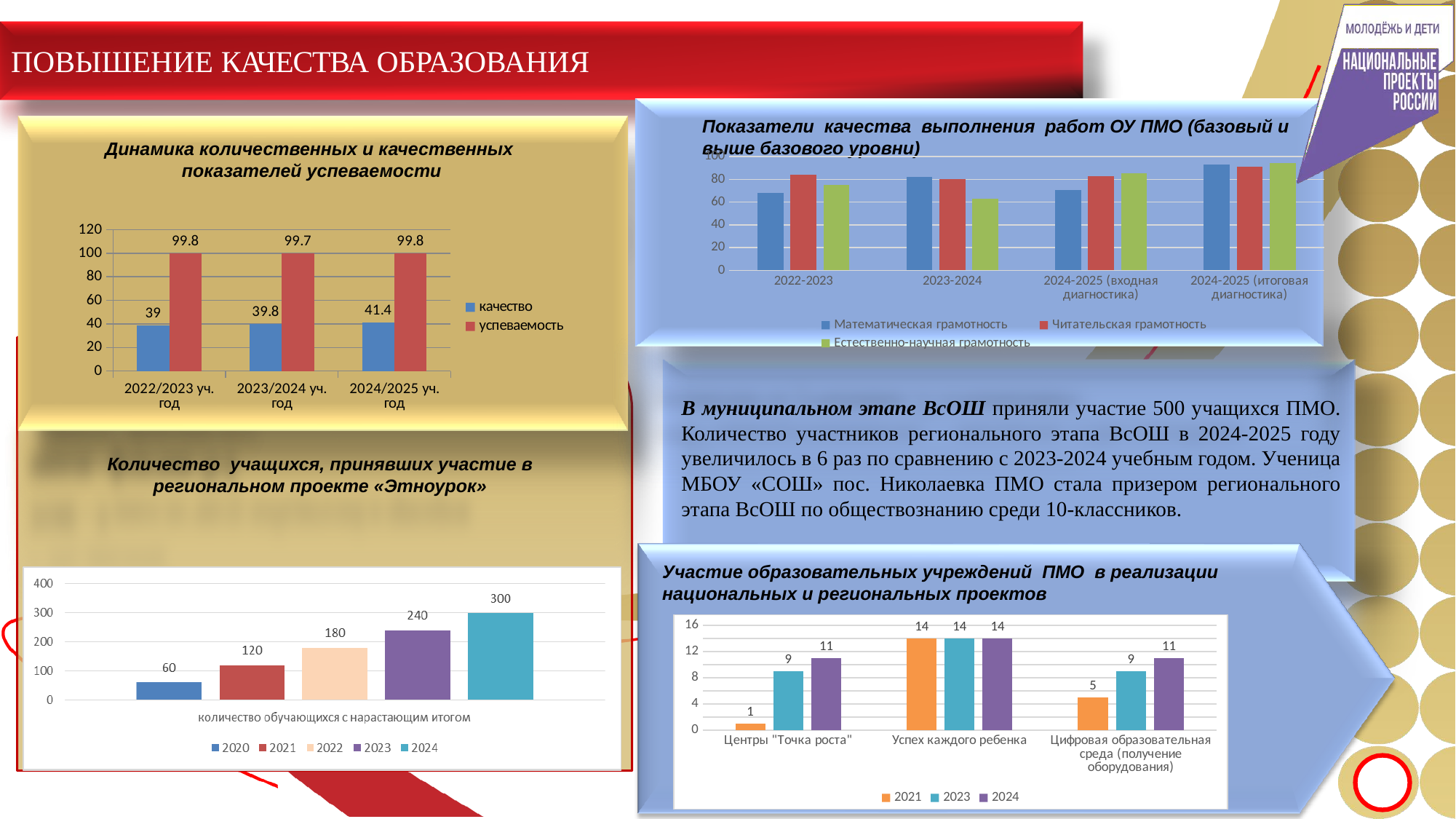
In the chart 'Показатели качества выполнения работ ОУ ПМО', how many series does the legend list? 3 In the chart 'Динамика количественных и качественных показателей успеваемости', what is the value of 'успеваемость' for 2023/2024 уч. год? 99.7 In the chart 'Показатели качества выполнения работ ОУ ПМО', is the value of 'Математическая грамотность' for 2024-2025 (итоговая диагностика) greater or less than 80? greater In the chart 'Показатели качества выполнения работ ОУ ПМО', is the value of 'Естественно-научная грамотность' for 2023-2024 greater or less than 80? less In the chart 'Динамика количественных и качественных показателей успеваемости', what is the value of 'качество' for 2024/2025 уч. год? 41.4 In the chart 'Динамика количественных и качественных показателей успеваемости', does 'качество' rise or fall from 2022/2023 to 2024/2025? rise In the chart 'Количество учащихся, принявших участие в региональном проекте «Этноурок»', what is the difference between the values for 2024 and 2020? 240 In the chart 'Динамика количественных и качественных показателей успеваемости', what is the difference between 'качество' for 2024/2025 уч. год and 2022/2023 уч. год? 2.4 In the chart 'Участие образовательных учреждений ПМО в реализации национальных и региональных проектов', what is the value for 2021 in 'Центры "Точка роста"'? 1 In the chart 'Количество учащихся, принявших участие в региональном проекте «Этноурок»', which year has the highest value? 2024 In the chart 'Количество учащихся, принявших участие в региональном проекте «Этноурок»', what is the value for 2022? 180 In the chart 'Участие образовательных учреждений ПМО в реализации национальных и региональных проектов', which is larger: the 2024 value for 'Цифровая образовательная среда' or the 2024 value for 'Успех каждого ребенка'? Успех каждого ребенка